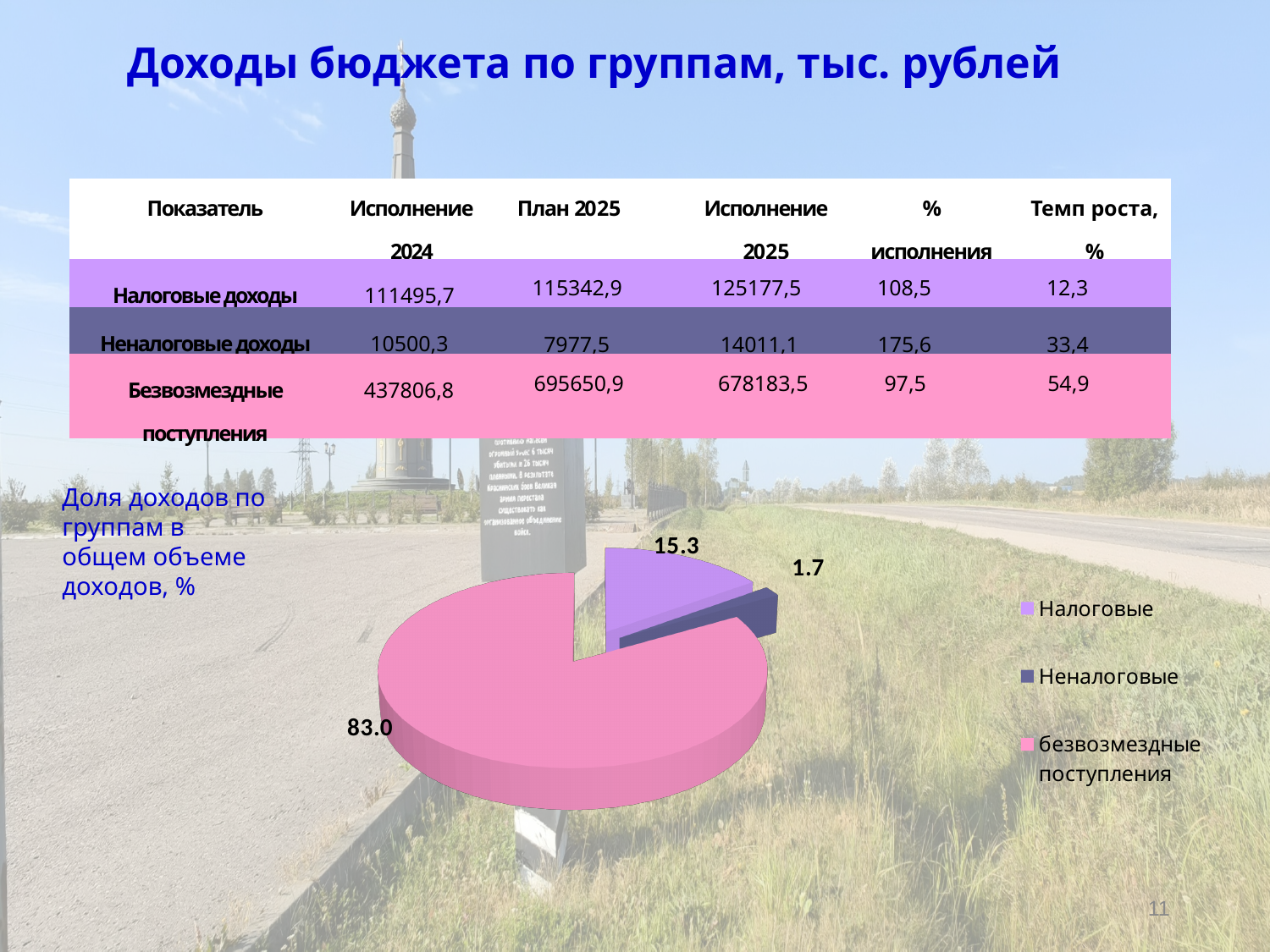
What is the difference between the shares of Налоговые and Неналоговые in the pie chart? 13.6 Which group has the largest slice in the pie chart? безвозмездные поступления How many slices does the pie chart have? 3 Which group has the smallest slice in the pie chart? Неналоговые What is the share of безвозмездные поступления in the pie chart? 83.0 What is the share of Налоговые in the pie chart? 15.3 What type of chart is shown on the slide? pie chart Which is larger in the pie chart: Налоговые or Неналоговые? Налоговые What is the title of the pie chart? Доля доходов по группам в общем объеме доходов, % What colour is the безвозмездные поступления slice in the pie chart? pink What is the share of Неналоговые in the pie chart? 1.7 How many entries does the pie chart legend list? 3